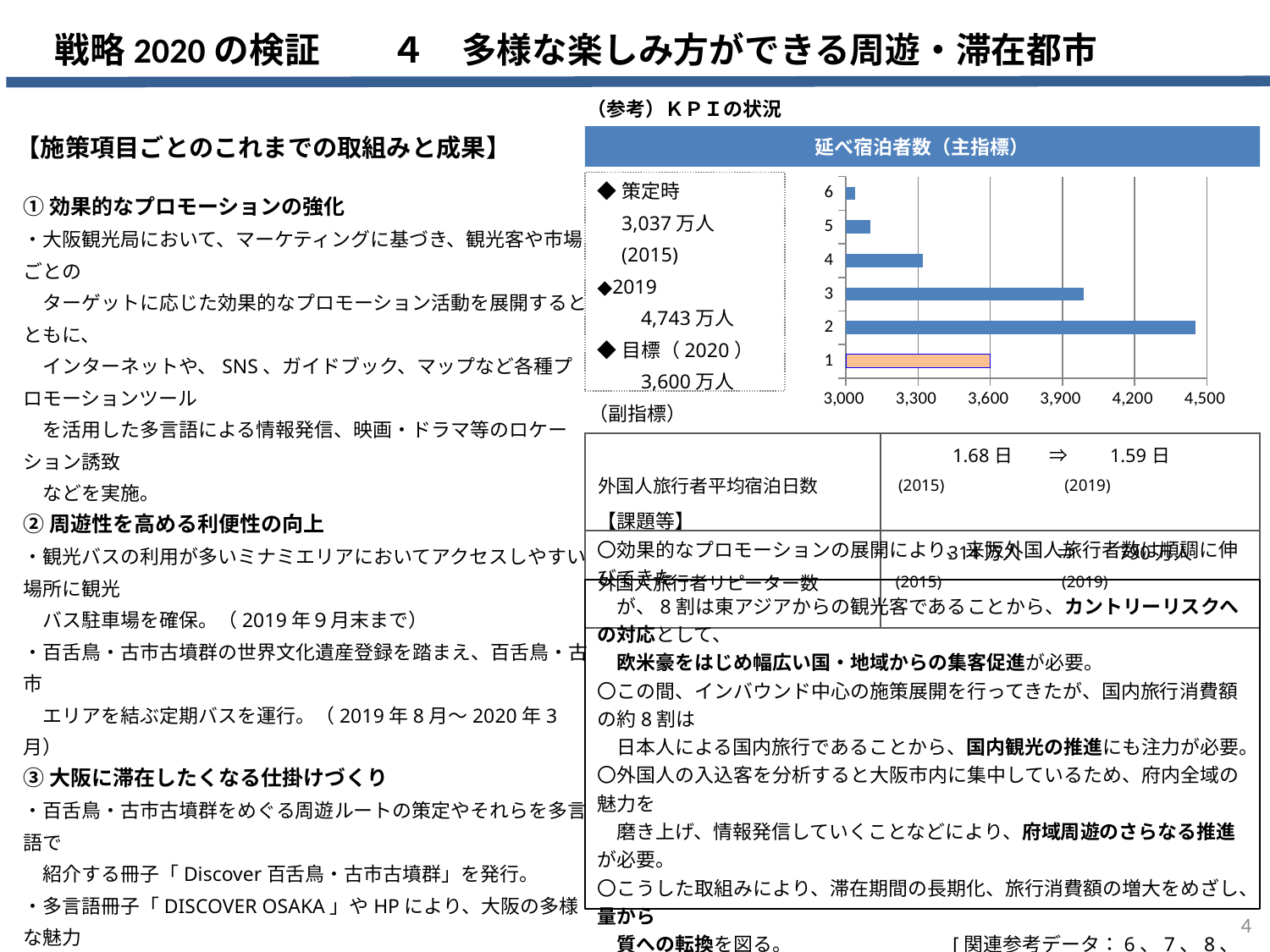
What kind of chart is shown under the heading 延べ宿泊者数（主指標）? bar chart In the 延べ宿泊者数（主指標） chart, is the value for category 4 greater or less than 3,600? less In the 延べ宿泊者数（主指標） chart, is the value for category 6 greater or less than 3,300? less In the 延べ宿泊者数（主指標） chart, is the value for category 3 greater or less than 3,900? greater Which category has the longest bar in the 延べ宿泊者数（主指標） chart? 2 Which category's bar is drawn in a different colour (orange) from the others in the 延べ宿泊者数（主指標） chart? 1 What is the title of the bar chart on the slide? 延べ宿泊者数（主指標） In the 延べ宿泊者数（主指標） chart, which has the larger value, category 3 or category 4? 3 Which category has the shortest bar in the 延べ宿泊者数（主指標） chart? 6 How many categories are plotted on the y axis of the 延べ宿泊者数（主指標） chart? 6